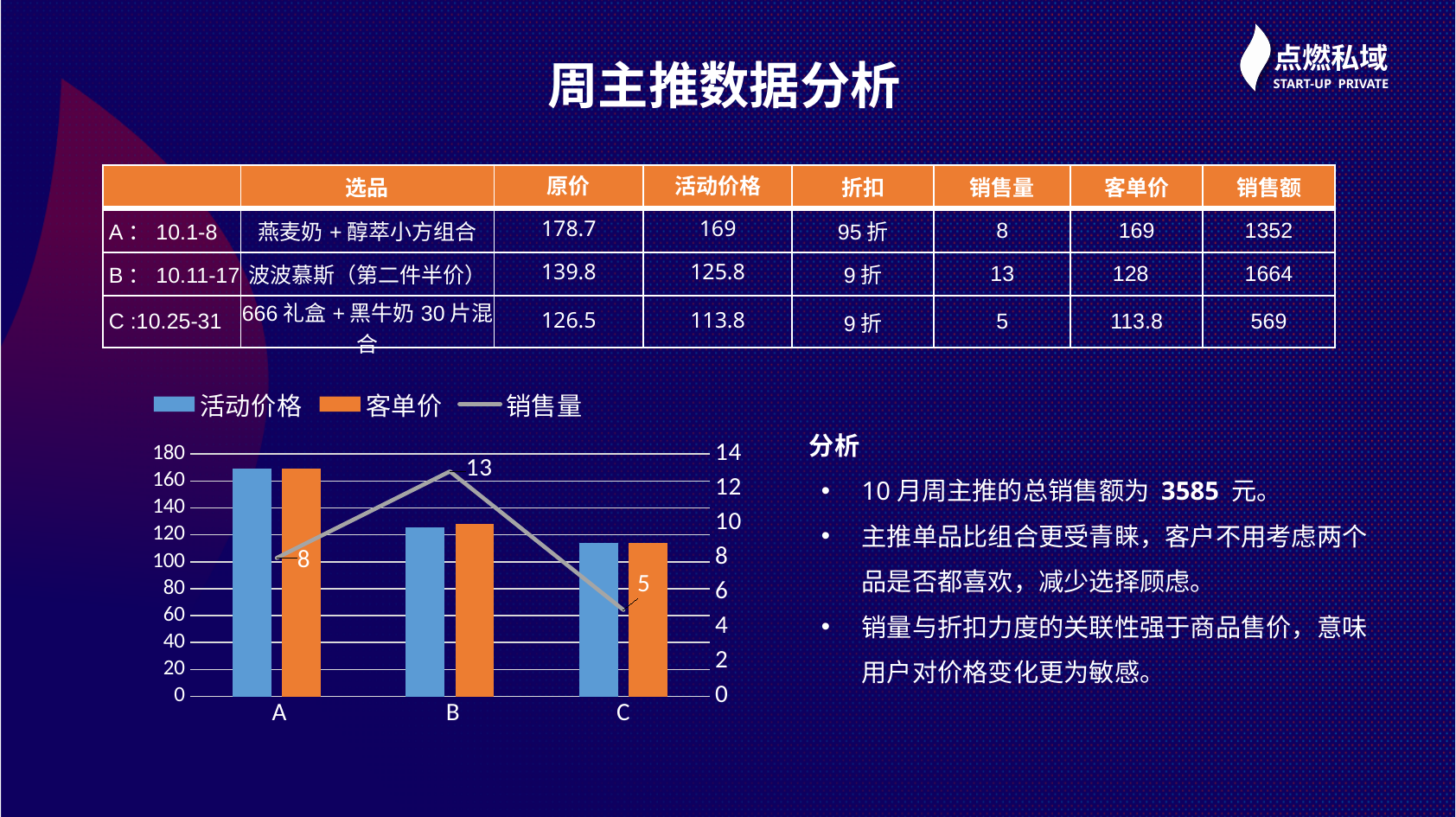
How many categories are shown on the x axis of the chart? 3 Is the 活动价格 bar for category A greater or less than 160? greater Is the 活动价格 bar for category C greater or less than 120? less Which category has a larger 活动价格 bar, A or C? A Does the 销售量 line rise or fall from category B to category C? fall What is the 销售量 value for category C in the chart? 5 What is the 销售量 value for category A in the chart? 8 Which category has the lowest 销售量 in the chart? C Which category has the highest 销售量 in the chart? B How many series does the chart legend list? 3 What is the 销售量 value for category B in the chart? 13 What is the difference in 销售量 between category B and category C? 8